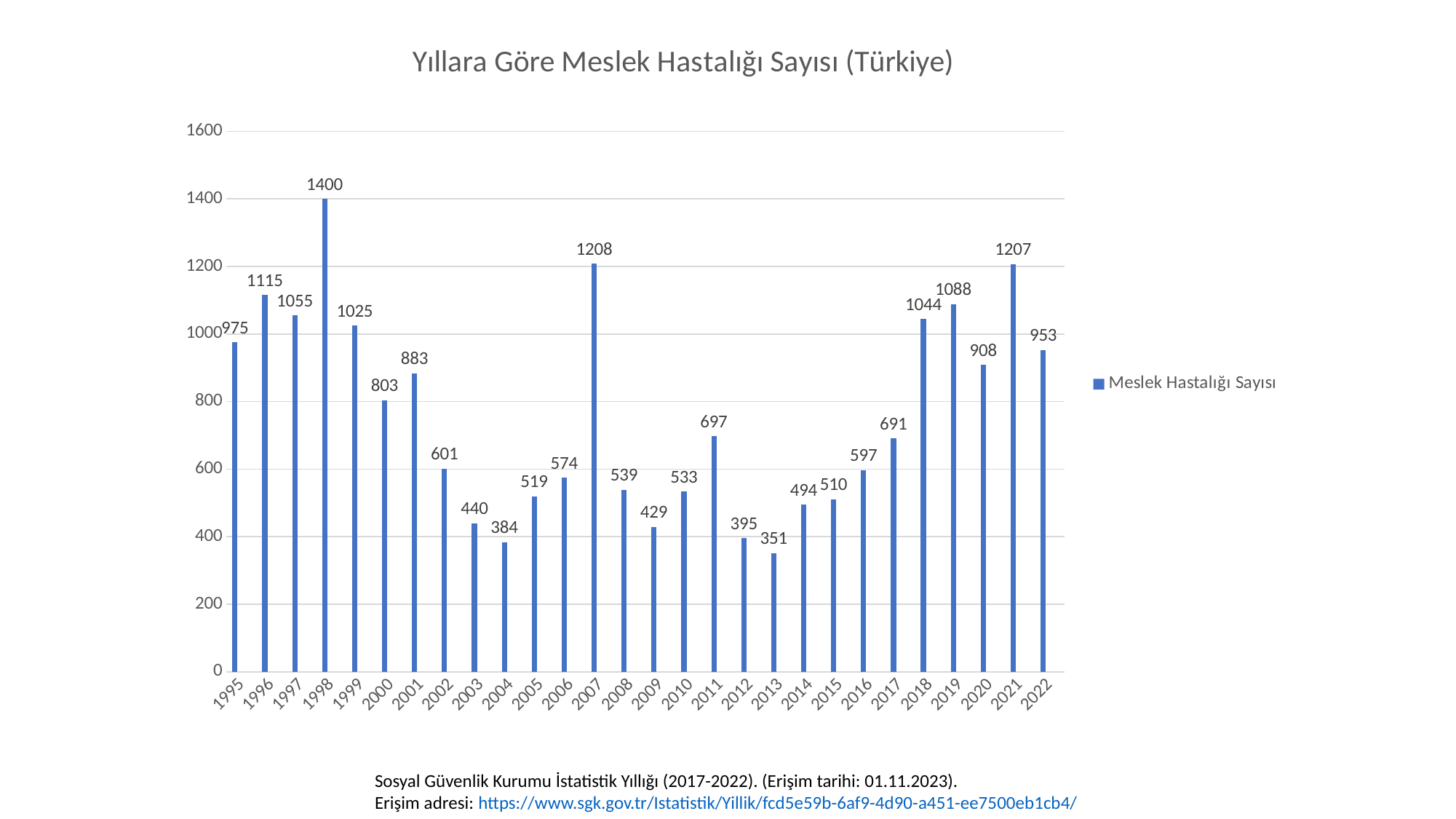
What is the value for 2007? 1208 What is the value for 2013? 351 Which year has the highest value? 1998 Which is larger, the value for 2001 or the value for 2000? 2001 Which year has the lowest value? 2013 What is the value for 2022? 953 What is the difference between the values for 2021 and 2020? 299 What is the title of the chart? Yıllara Göre Meslek Hastalığı Sayısı (Türkiye) What is the value for 1998? 1400 What kind of chart is this? bar chart Is the value for 2019 greater or less than 1000? greater How many years are shown on the x axis? 28